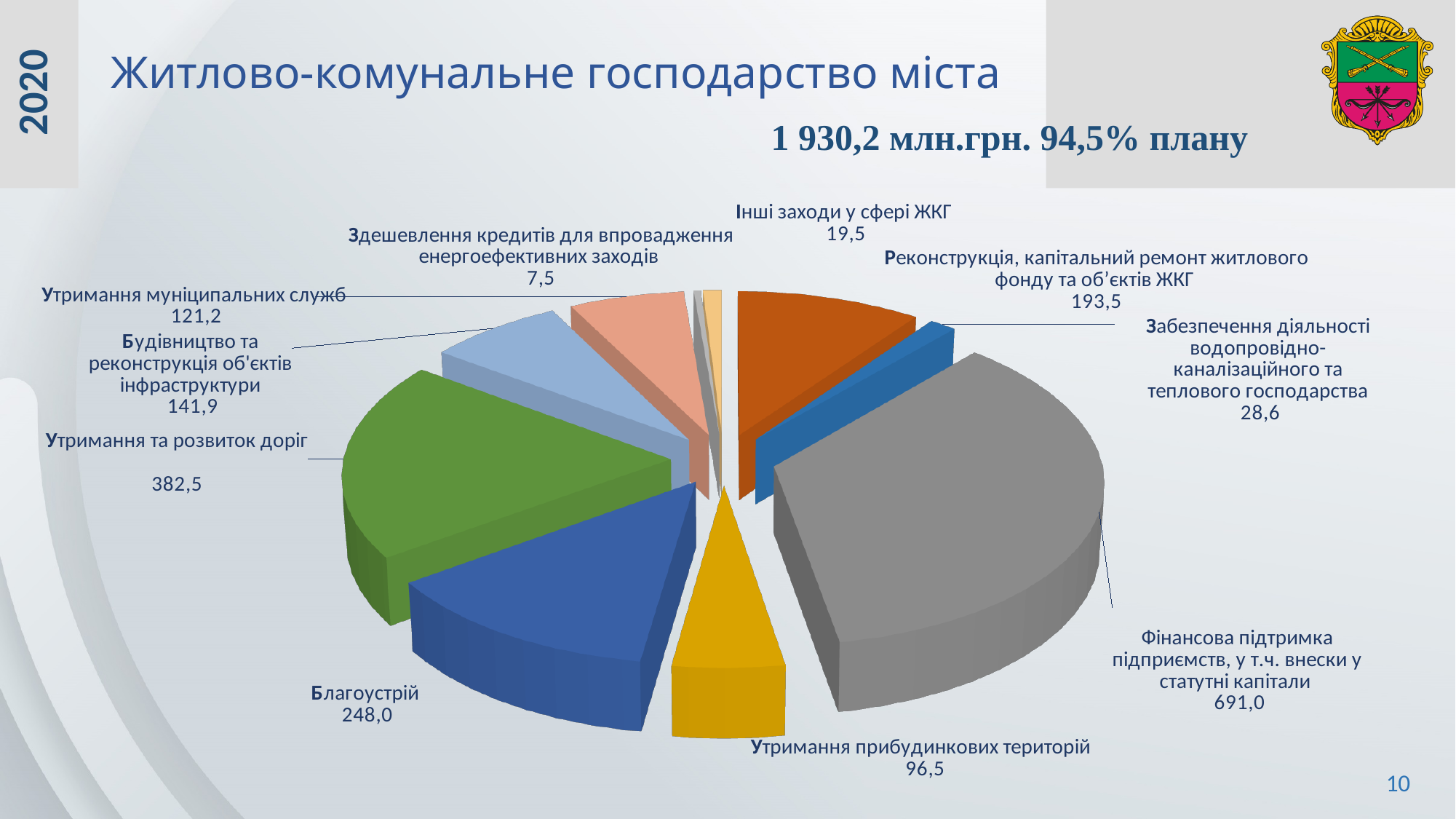
What is the difference between the values for Фінансова підтримка підприємств and Утримання та розвиток доріг? 308,5 Which is larger: the value for Утримання муніципальних служб or the value for Будівництво та реконструкція об'єктів інфраструктури? Будівництво та реконструкція об'єктів інфраструктури What kind of chart is shown on the slide? Pie chart What is the value for Фінансова підтримка підприємств, у т.ч. внески у статутні капітали? 691,0 How many categories are shown in the pie chart? 10 What is the value for Здешевлення кредитів для впровадження енергоефективних заходів? 7,5 Which category has the largest slice of the pie? Фінансова підтримка підприємств, у т.ч. внески у статутні капітали What is the value for Утримання та розвиток доріг? 382,5 What is the difference between the values for Благоустрій and Реконструкція, капітальний ремонт житлового фонду та об'єктів ЖКГ? 54,5 Which category has the smallest slice of the pie? Здешевлення кредитів для впровадження енергоефективних заходів What total amount in млн.грн. is stated above the chart? 1 930,2 млн.грн. What is the value for Утримання прибудинкових територій? 96,5